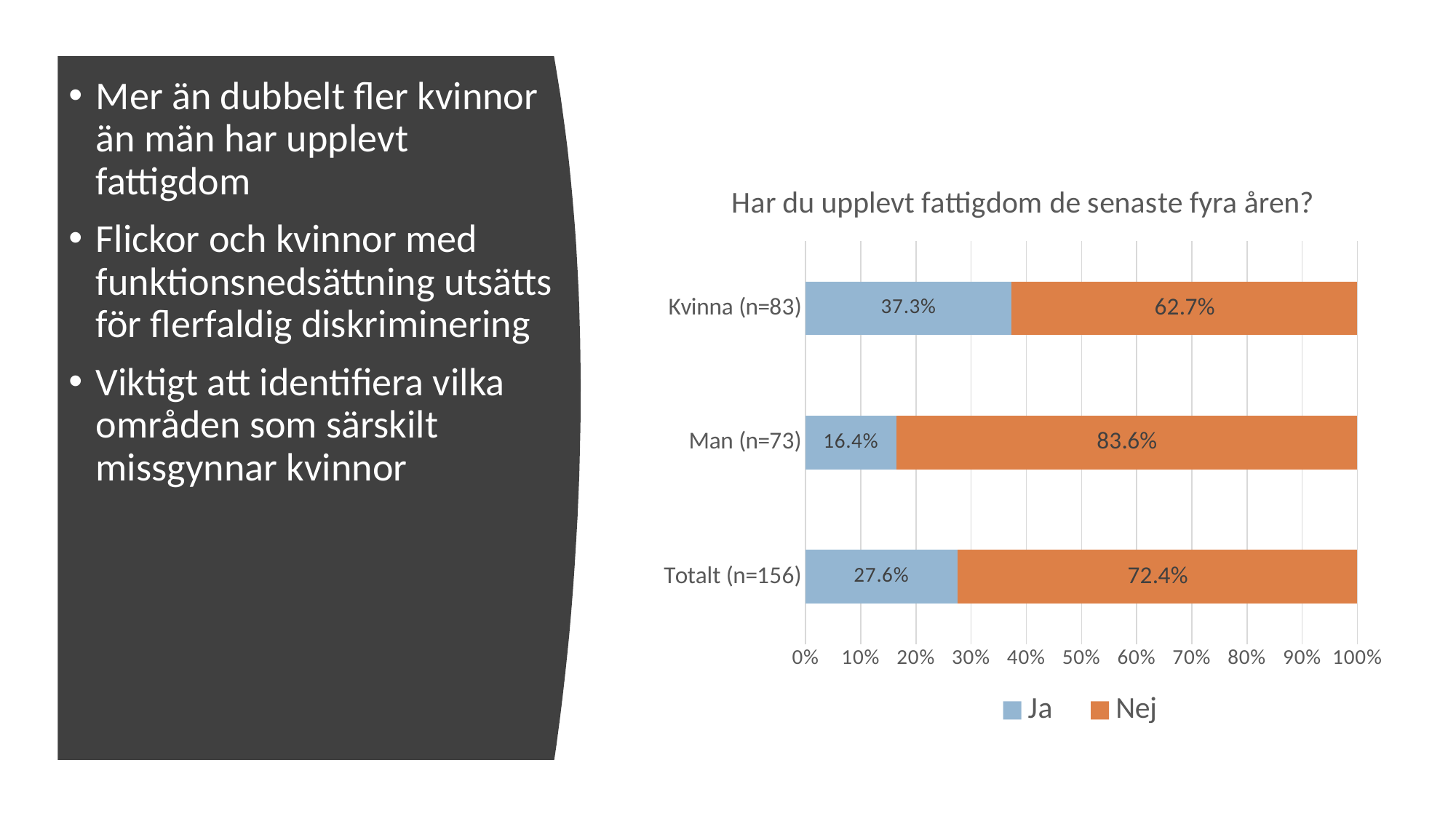
What is the 'Ja' value for Kvinna (n=83)? 37.3% How many categories are shown on the chart? 3 What is the 'Nej' value for Kvinna (n=83)? 62.7% What is the 'Nej' value for Man (n=73)? 83.6% What kind of chart is shown? Stacked bar chart Which category has the lowest 'Ja' value? Man (n=73) Which category has the highest 'Ja' value? Kvinna (n=83) Which is larger: the 'Nej' value for Man (n=73) or for Totalt (n=156)? Man (n=73) What is the difference between the 'Ja' values for Kvinna (n=83) and Man (n=73)? 20.9% Is the 'Ja' value for Totalt (n=156) greater or less than 30%? less What is the 'Ja' value for Totalt (n=156)? 27.6% How many series does the legend list? 2